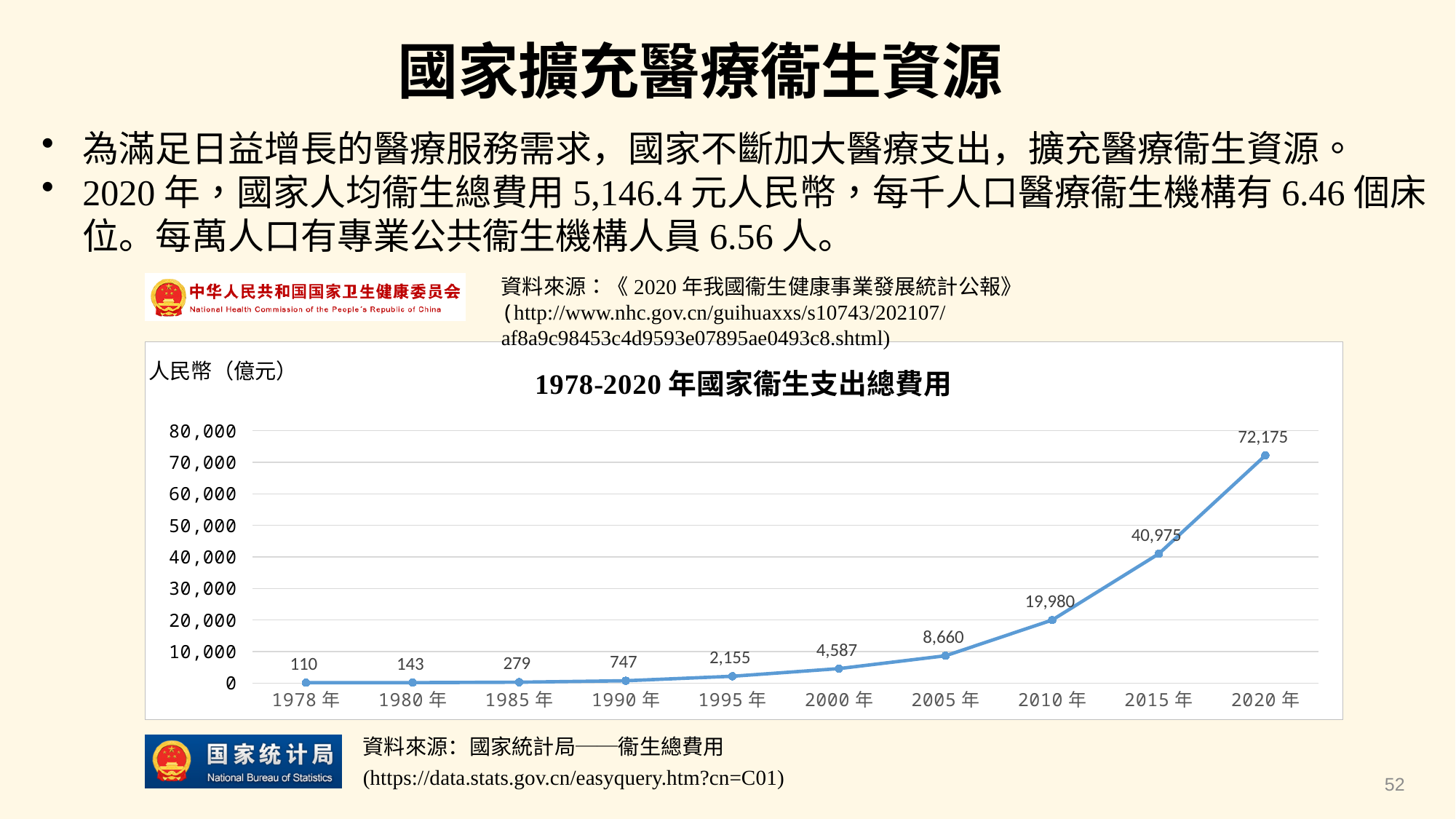
What is the difference between the values for 2020 年 and 2015 年? 31,200 Which year has the lowest value in the chart? 1978 年 What is the value for 2005 年 in the chart? 8,660 What is the value for 1978 年 in the chart? 110 Which year has the highest value in the chart? 2020 年 What type of chart is shown on the slide? line chart How many data points are plotted in the chart? 10 What is the value for 2020 年 in the chart 1978-2020 年國家衛生支出總費用? 72,175 What is the difference between the values for 2010 年 and 2005 年? 11,320 Which is larger, the value for 2000 年 or the value for 1990 年? 2000 年 What is the value for 1995 年 in the chart? 2,155 Do the values rise or fall from 1978 年 to 2020 年? rise